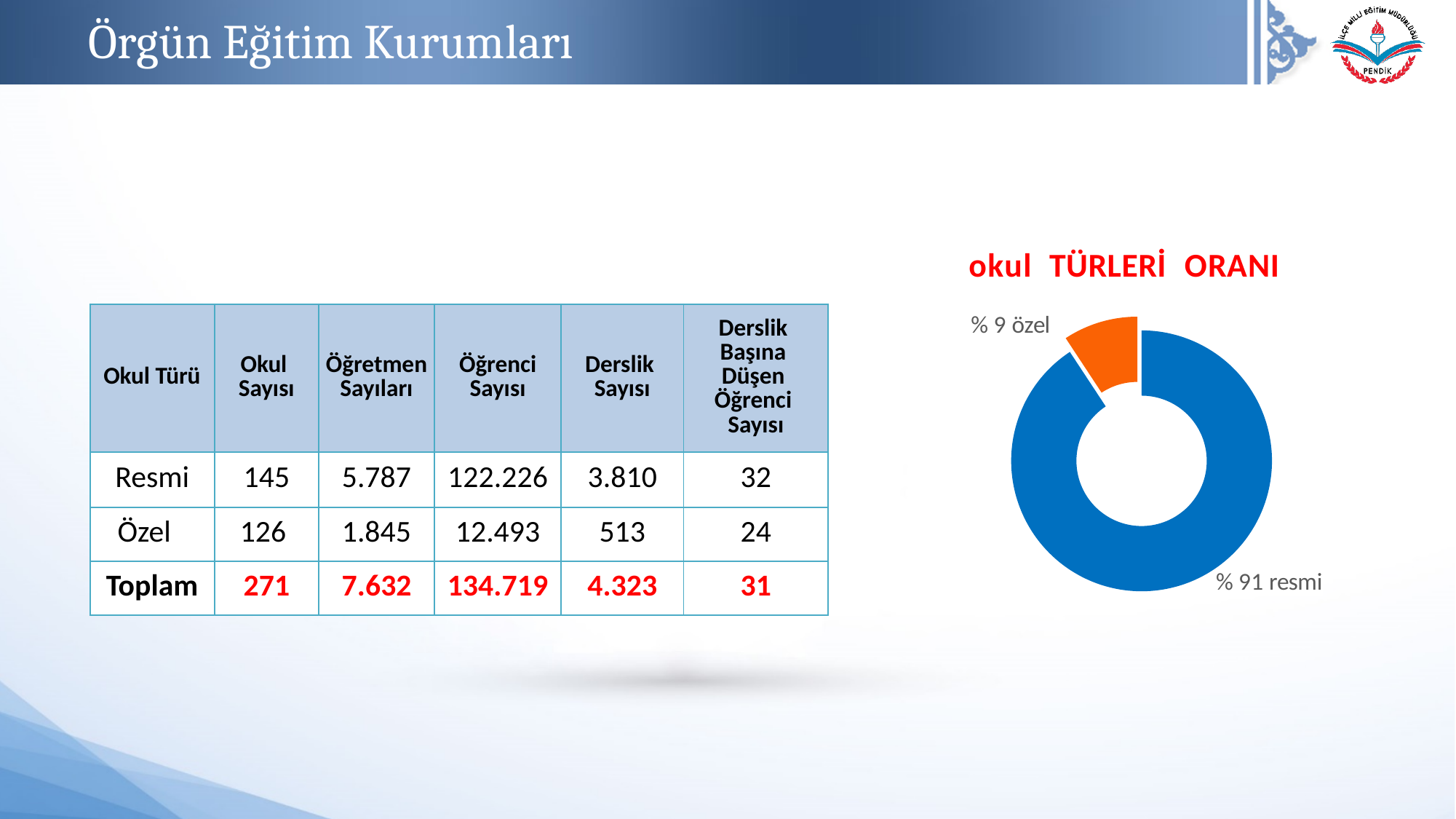
Which is larger in the chart, the 'resmi' slice or the 'özel' slice? resmi What kind of chart is shown on the slide? Pie chart (donut) What share of the chart does the 'resmi' slice represent? % 91 Which slice of the chart is the smallest? özel What share of the chart does the 'özel' slice represent? % 9 Which slice of the chart is the largest? resmi What is the difference in percentage points between the 'resmi' and 'özel' slices? 82 What is the title of the chart on the slide? okul TÜRLERİ ORANI What colour is the 'özel' slice in the chart? Orange How many slices does the chart have? 2